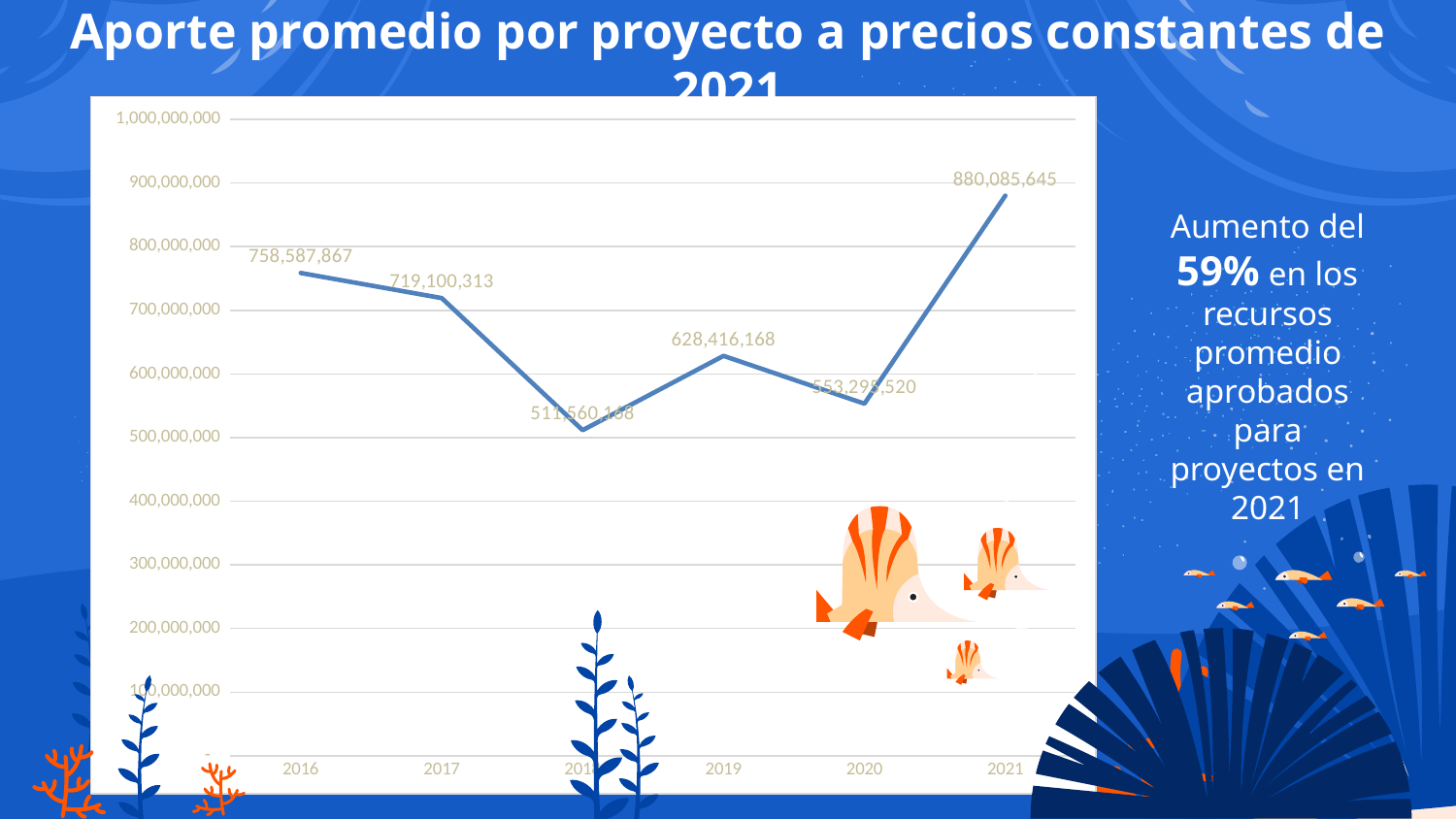
What is the value for 2016? 758,587,867 What is the value for 2021? 880,085,645 What is the difference between the values for 2021 and 2016? 121,497,778 Which year has the highest value? 2021 Between 2020 and 2021, does the value rise or fall? rise Which is larger, the value for 2016 or the value for 2017? 2016 Is the value for 2020 greater or less than 600,000,000? less How many years are plotted on the chart? 6 What is the value for 2019? 628,416,168 What is the difference between the values for 2016 and 2017? 39,487,554 What is the value for 2017? 719,100,313 What kind of chart is shown on the slide? line chart